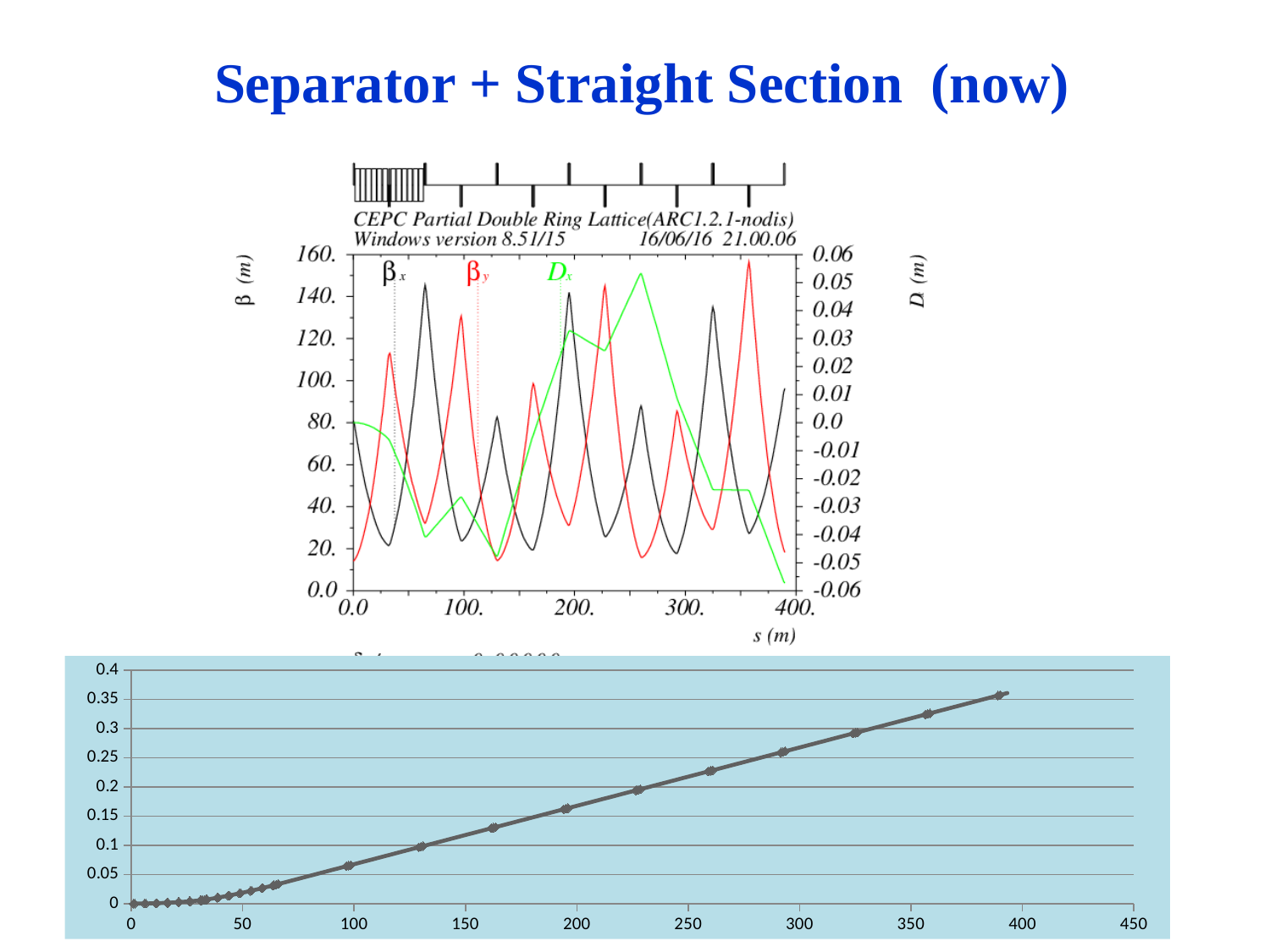
In the bottom chart, is the value at x = 250 greater or less than 0.2? greater In the bottom chart, is the value at x = 350 greater or less than 0.3? greater What kind of chart is the top chart? Line chart In the top chart, is the highest peak of β_y greater or less than 140? greater In the top chart, which series reaches the highest β value? β_y What kind of chart is the bottom chart? Line chart What is the label of the x axis of the top chart? s (m) In the bottom chart, do the values rise or fall as x increases? Rise How many series does the top chart plot? 3 In the top chart, what colour is the D_x curve? Green What is the title of the top chart? CEPC Partial Double Ring Lattice(ARC1.2.1-nodis)